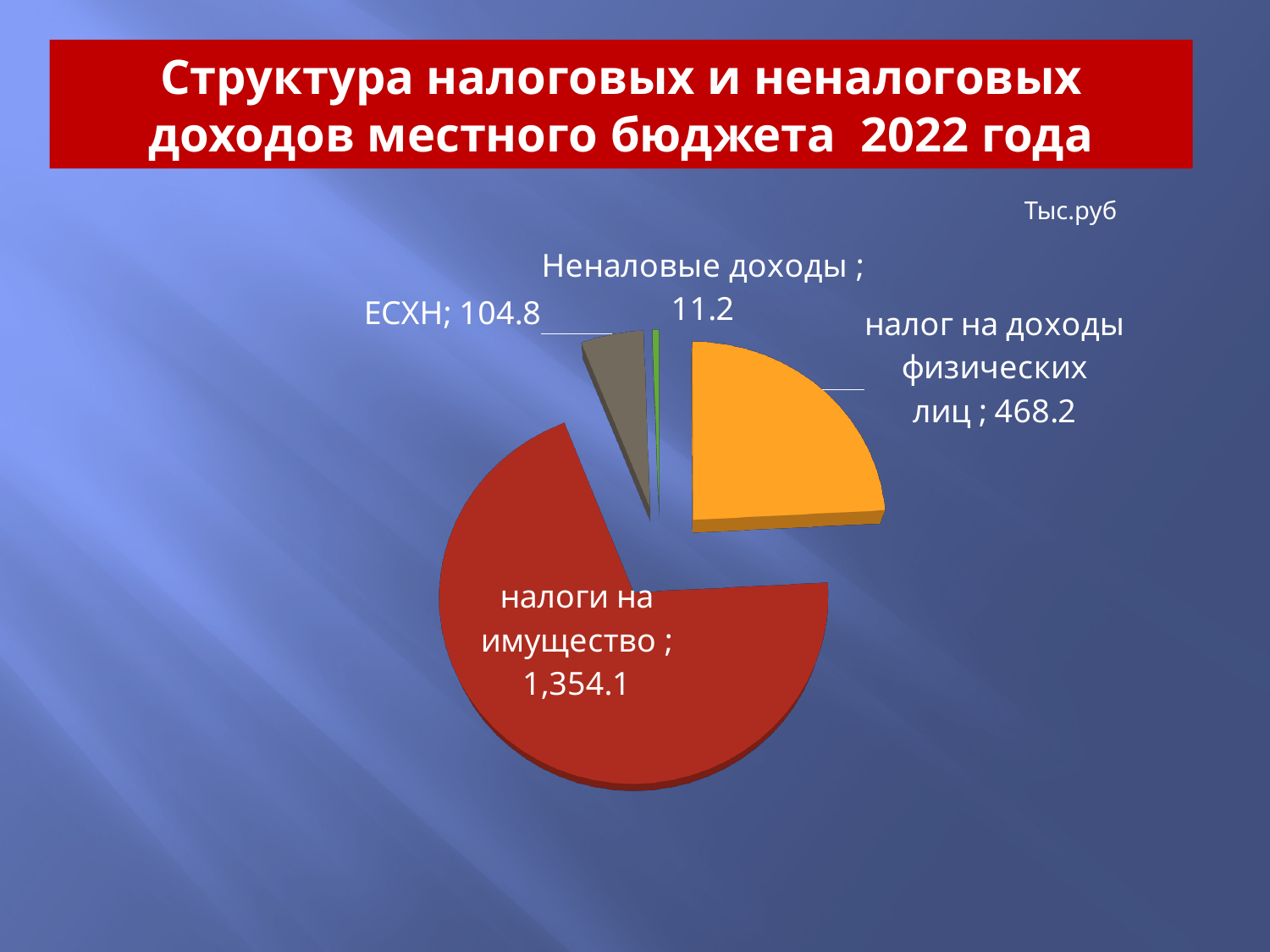
What is the value for Неналовые доходы? 11.2 Which category has the smallest slice of the pie? Неналовые доходы What is the value for налог на доходы физических лиц? 468.2 What type of chart is shown on the slide? Pie chart How many slices does the pie chart have? 4 Which category has the largest slice of the pie? налоги на имущество What is the value for налоги на имущество? 1,354.1 What is the difference between налоги на имущество and налог на доходы физических лиц? 885.9 What is the value for ЕСХН? 104.8 Which is larger, налог на доходы физических лиц or ЕСХН? налог на доходы физических лиц What unit is indicated for the values in the chart? Тыс.руб What is the difference between ЕСХН and Неналовые доходы? 93.6